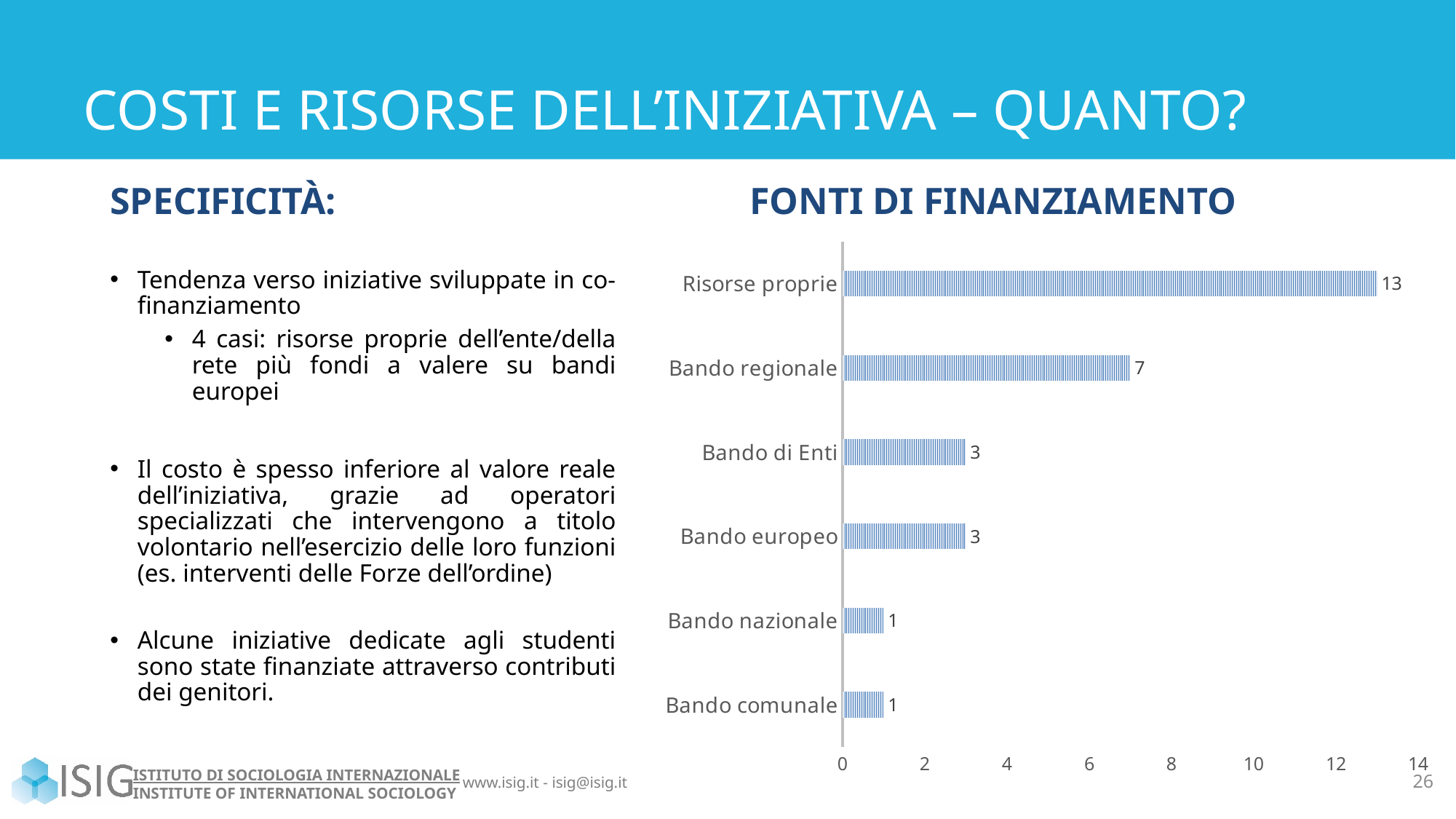
What is the difference between the values for Risorse proprie and Bando regionale? 6 What is the value for Risorse proprie? 13 What is the title of the chart? FONTI DI FINANZIAMENTO What kind of chart is shown on the slide? bar chart What is the value for Bando regionale? 7 Is the value for Risorse proprie greater or less than 10? greater Which is larger, the value for Bando regionale or the value for Bando di Enti? Bando regionale What is the value for Bando europeo? 3 How many categories are shown in the chart? 6 Which category has the highest value? Risorse proprie What is the value for Bando nazionale? 1 What is the maximum value shown on the horizontal axis? 14